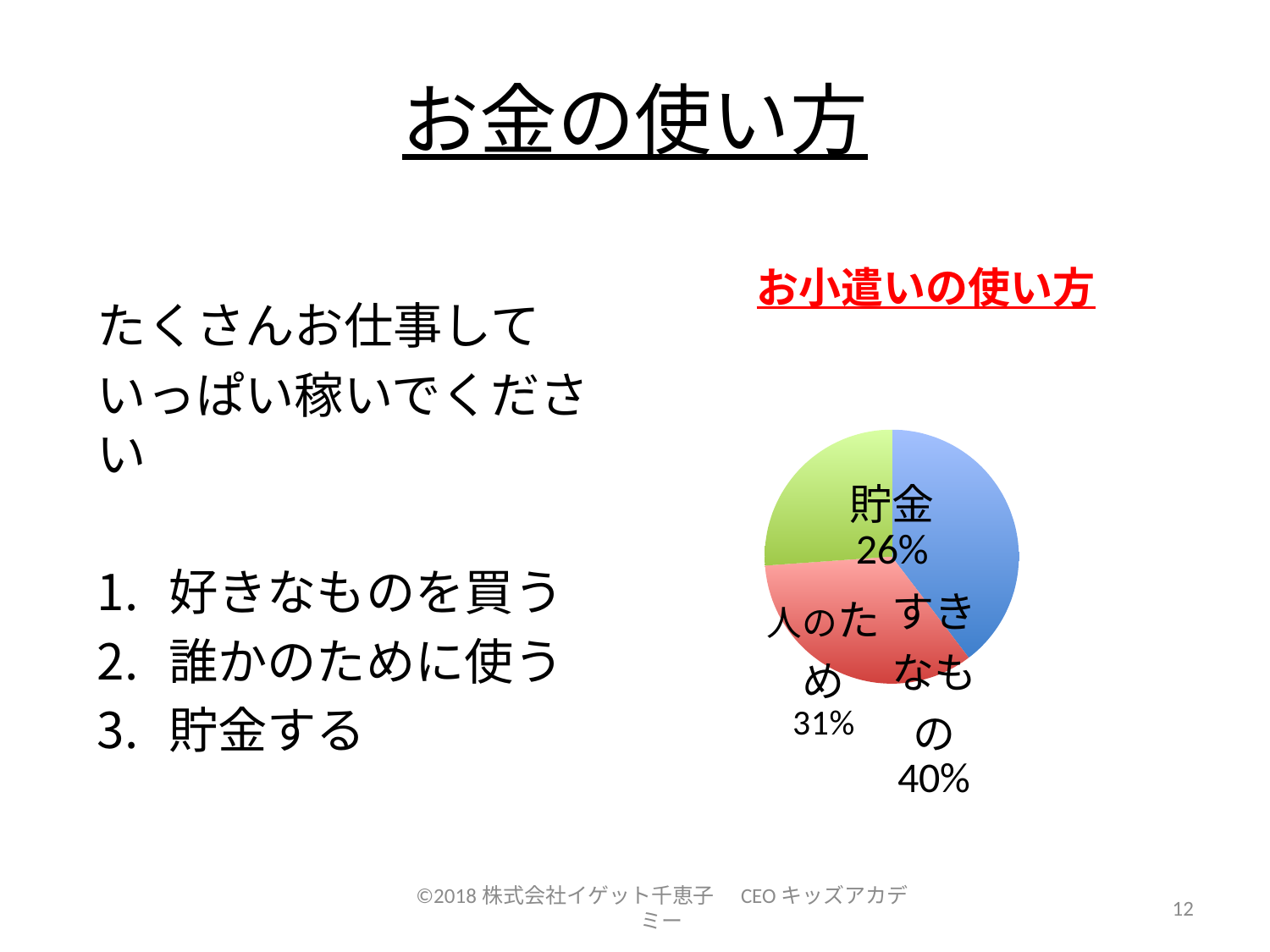
Which slice of the pie chart is the largest? すきなもの What colour is the 貯金 slice in the pie chart? Green What is the difference in percentage points between すきなもの and 貯金 in the pie chart? 14 How many slices does the pie chart have? 3 What percentage is shown for 人のため in the pie chart? 31% What percentage is shown for すきなもの in the pie chart? 40% What is the title of the pie chart? お小遣いの使い方 What is the difference in percentage points between 人のため and 貯金 in the pie chart? 5 Which is larger in the pie chart, 人のため or 貯金? 人のため Which slice of the pie chart is the smallest? 貯金 What percentage is shown for 貯金 in the pie chart? 26% What kind of chart is shown on the slide? Pie chart